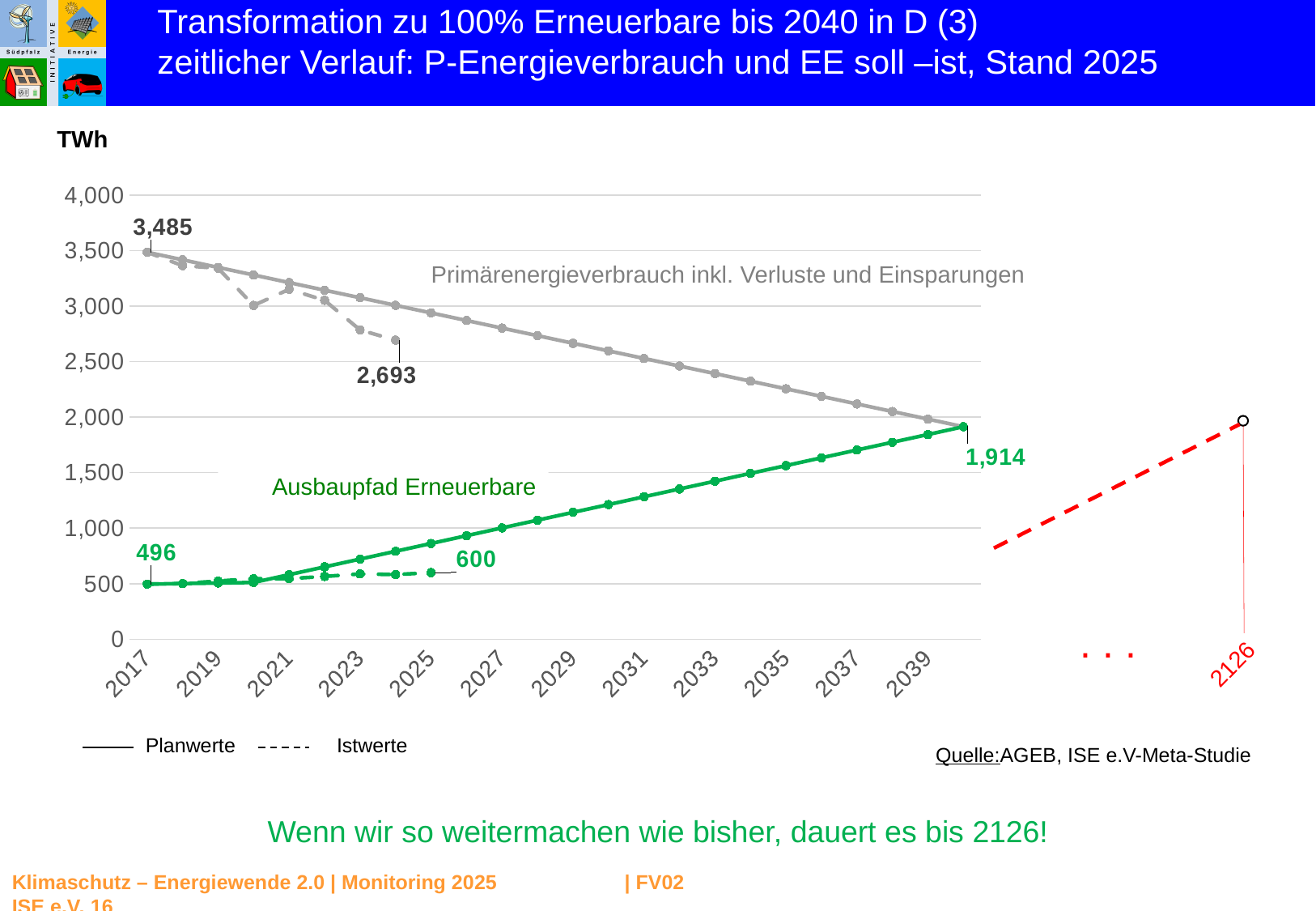
Does the solid Primärenergieverbrauch plan line rise or fall from 2017 to 2040? fall What is the labelled Istwert at the end of the dashed Ausbaupfad Erneuerbare line? 600 How much lower is the labelled Istwert 2,693 than the 2017 Primärenergieverbrauch value of 3,485? 792 What is the value of the Ausbaupfad Erneuerbare line in 2017? 496 At what value do the Primärenergieverbrauch and Ausbaupfad Erneuerbare plan lines meet at the right end of the chart? 1,914 How many entries does the legend below the chart list? 2 Is the Ausbaupfad Erneuerbare plan value in 2035 greater or less than 1,000? greater What is the value of the Primärenergieverbrauch line in 2017? 3,485 What is the labelled Istwert at the end of the dashed Primärenergieverbrauch line? 2,693 What is the difference between the 2017 Primärenergieverbrauch value (3,485) and the 2017 Ausbaupfad Erneuerbare value (496)? 2,989 In 2017, which is larger: the Primärenergieverbrauch value or the Ausbaupfad Erneuerbare value? Primärenergieverbrauch What kind of chart is shown on the slide? line chart